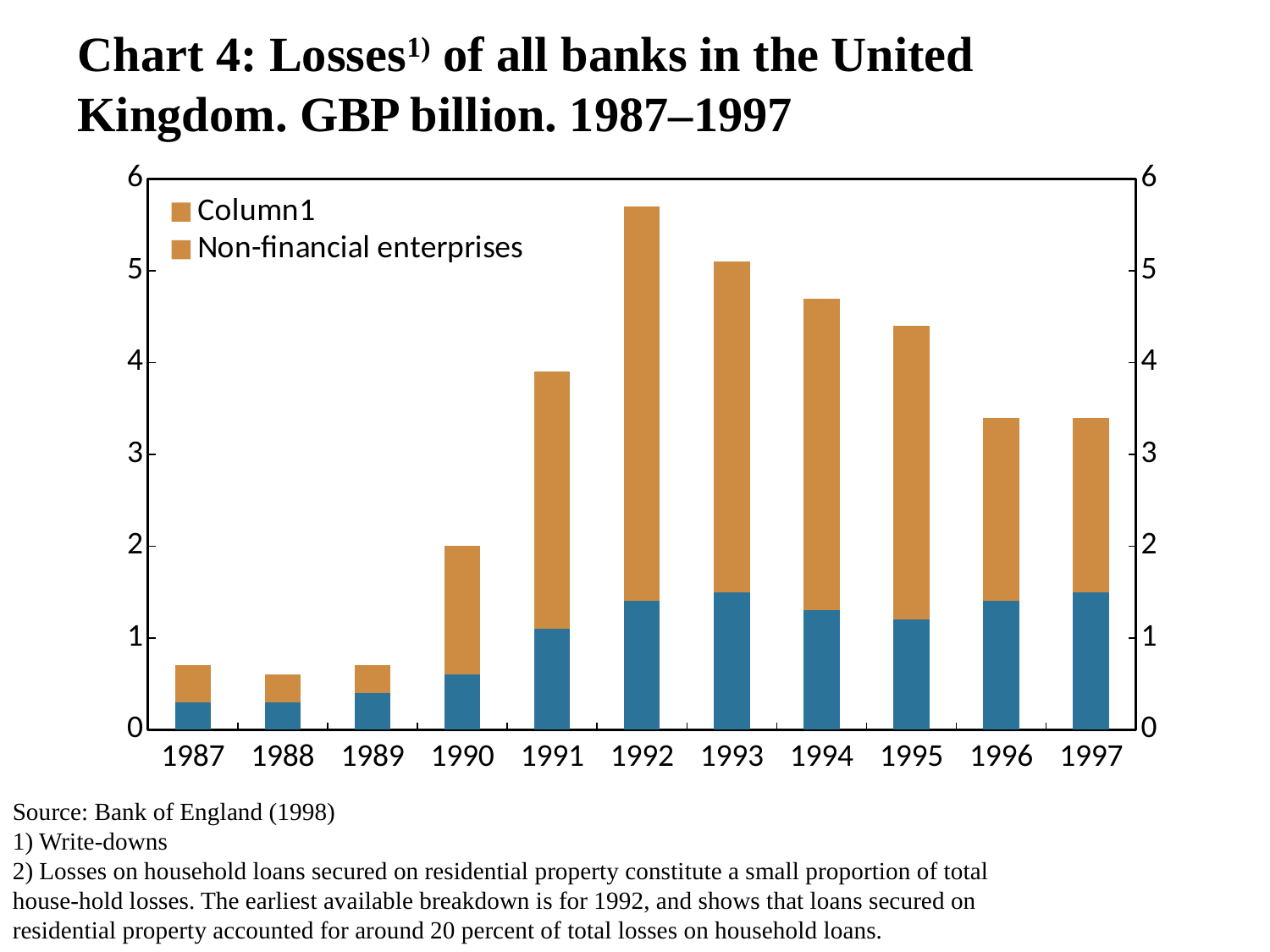
What source is cited below the chart? Bank of England (1998) Is the total bar for 1992 greater or less than 5? greater Is the total bar for 1987 greater or less than 1? less Is the total bar for 1994 greater or less than 5? less Which year has the larger total bar, 1990 or 1991? 1991 How many series does the chart's legend list? 2 How many years are shown on the x axis of the chart? 11 Do the total losses rise or fall from 1992 to 1997? fall What kind of chart is shown on the slide? Stacked bar chart Which year has the larger total bar, 1992 or 1993? 1992 Which year has the highest total losses in the chart? 1992